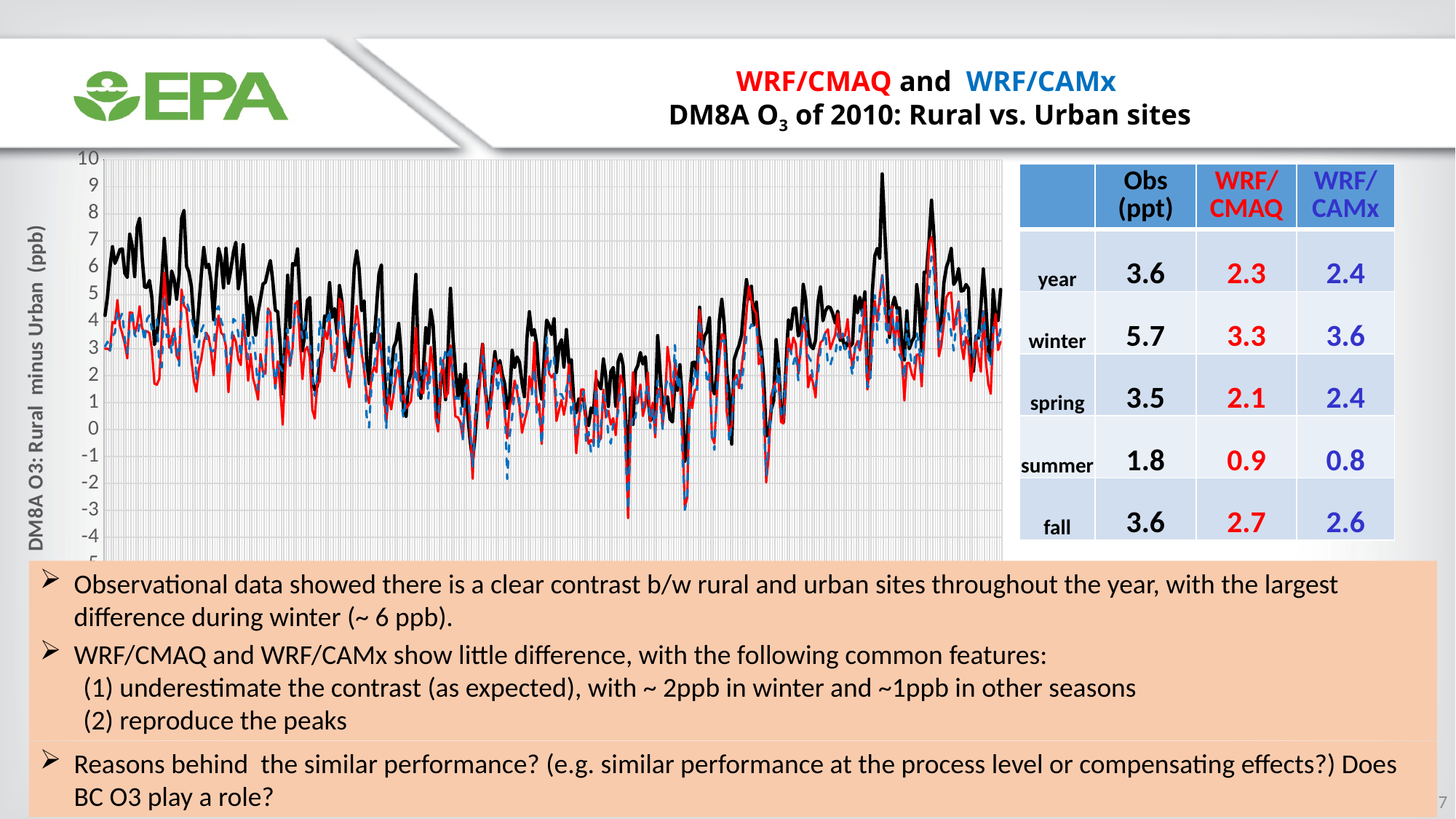
What is the label of the chart's vertical axis? DM8A O3: Rural minus Urban (ppb) Is the lowest point of the red line greater or less than -2? less What is the highest tick value shown on the chart's vertical axis? 10 What kind of chart is shown on the left of the slide? line chart Does the black line ever drop below -4 on the chart? no Is the highest peak of the black line greater or less than 8? greater Which line generally sits highest on the chart, the black line or the red line? black How many lines are plotted on the chart? 3